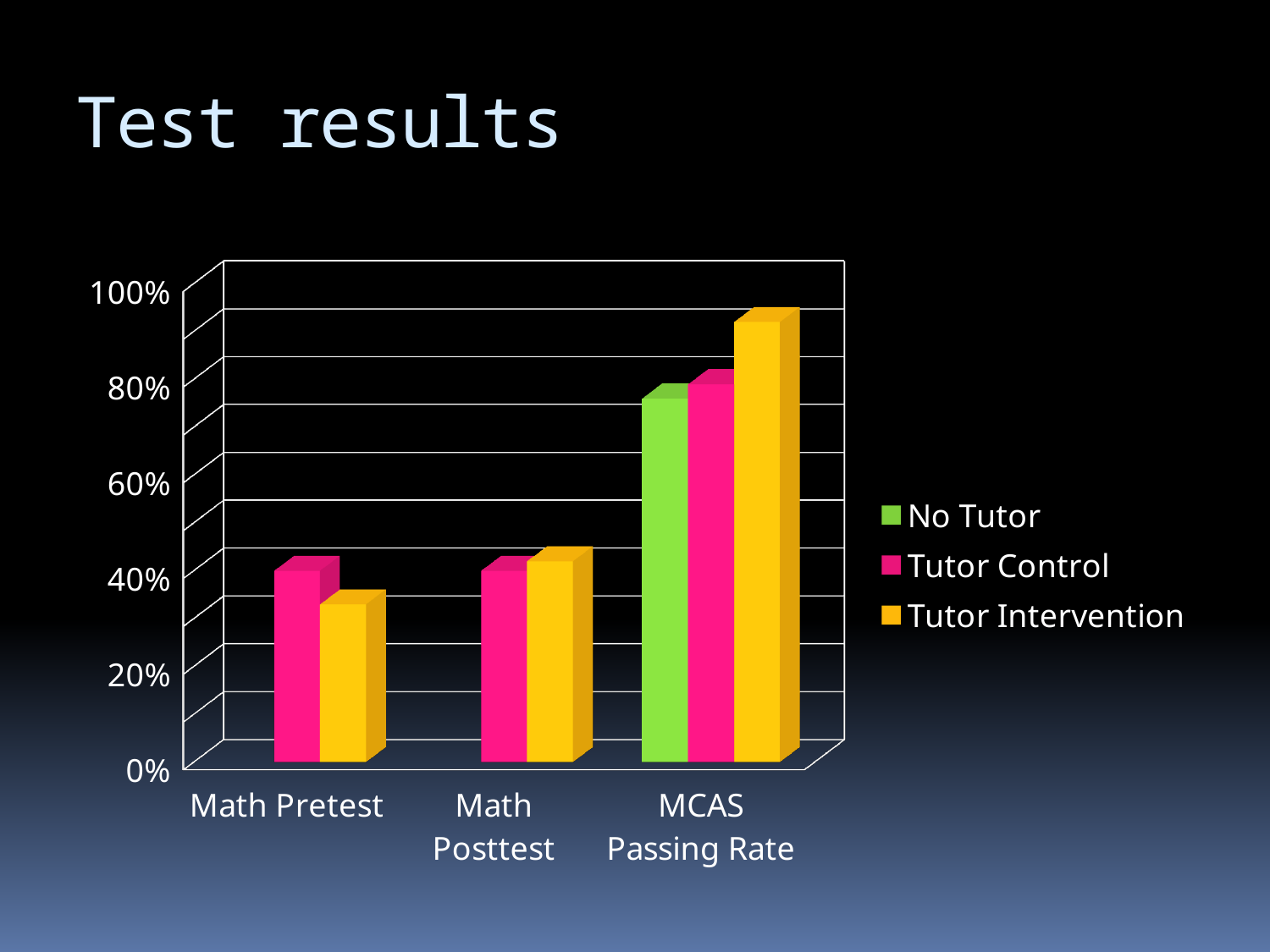
How many categories are shown on the x axis? 3 Is the Tutor Intervention value for MCAS Passing Rate greater or less than 80%? greater Do the Tutor Intervention values rise or fall from Math Pretest to MCAS Passing Rate? rise Is the Tutor Intervention value for Math Pretest greater or less than 40%? less For MCAS Passing Rate, which is larger: No Tutor or Tutor Intervention? Tutor Intervention What kind of chart is shown on the slide? bar chart How many series does the legend list? 3 For Math Pretest, which is larger: Tutor Control or Tutor Intervention? Tutor Control Which category has the highest Tutor Intervention value? MCAS Passing Rate Which category has the lowest Tutor Intervention value? Math Pretest Which category is the only one with a No Tutor bar? MCAS Passing Rate What is the title of the chart? Test results